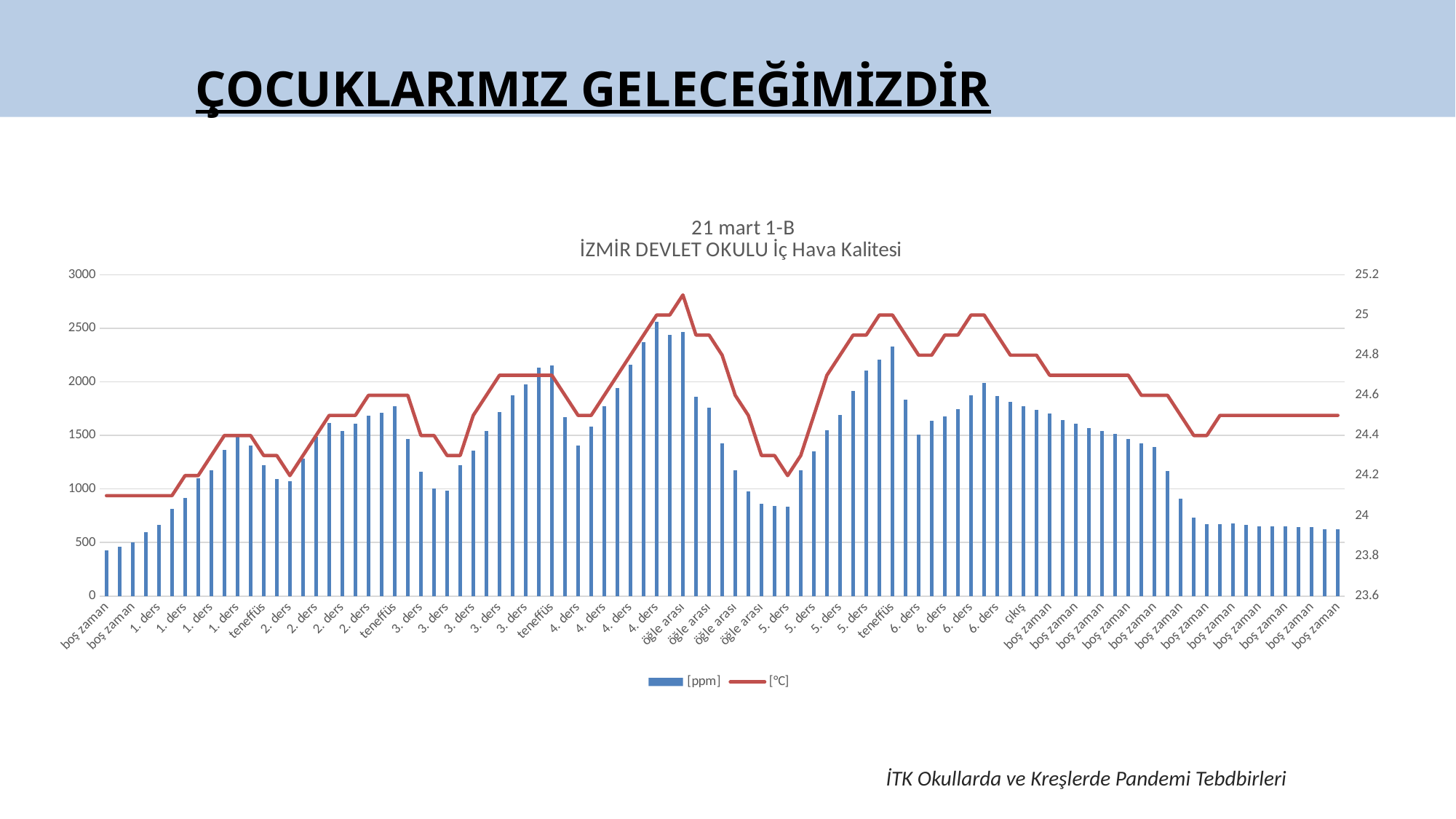
Is the [ppm] value for the last bar (rightmost boş zaman) greater or less than 500? greater What are the two series named in the legend? [ppm] and [°C] Is the [ppm] value for the first bar (leftmost boş zaman) greater or less than 500? less Is the [°C] value at the first category (leftmost boş zaman) greater or less than 24.2? less What is the title of the chart? 21 mart 1-B İZMİR DEVLET OKULU İç Hava Kalitesi What kind of chart is shown on the slide? A combined bar and line chart How many series does the legend list? 2